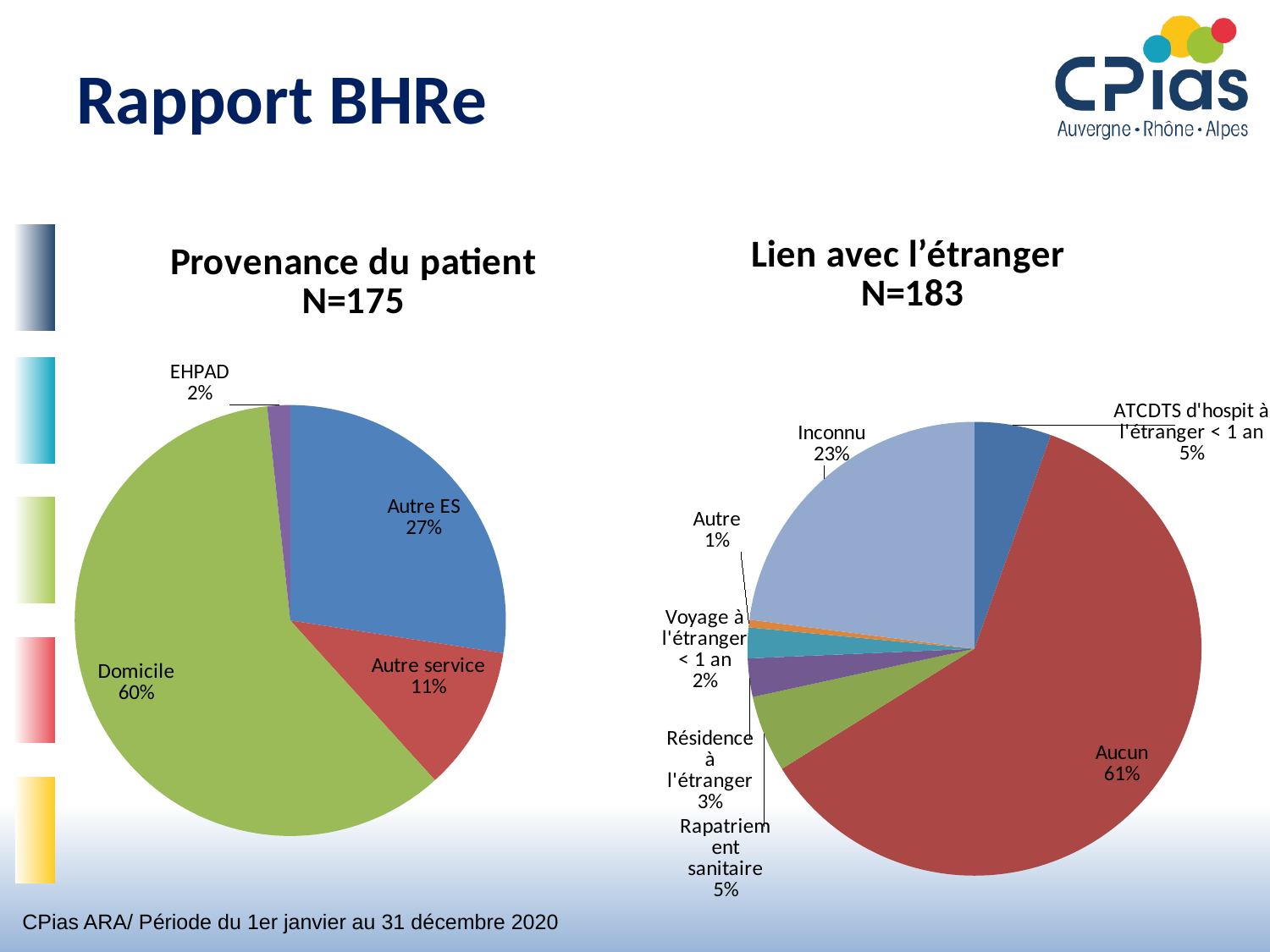
In the 'Provenance du patient' chart, how many categories are shown? 4 In the 'Provenance du patient' chart, which category has the smallest slice? EHPAD What is the N value stated in the title of the 'Lien avec l'étranger' chart? N=183 In the 'Lien avec l'étranger' chart, which is larger: Résidence à l'étranger or Voyage à l'étranger < 1 an? Résidence à l'étranger What type of chart is used for 'Lien avec l'étranger'? Pie chart In the 'Provenance du patient' chart, what percentage is shown for Autre ES? 27% In the 'Lien avec l'étranger' chart, how many categories are shown? 7 In the 'Provenance du patient' chart, what is the difference in percentage points between Autre ES and Autre service? 16 In the 'Lien avec l'étranger' chart, what percentage is shown for Inconnu? 23% In the 'Provenance du patient' chart, what share of patients come from Domicile? 60% In the 'Lien avec l'étranger' chart, what percentage is shown for Rapatriement sanitaire? 5% In the 'Lien avec l'étranger' chart, which category has the largest slice? Aucun